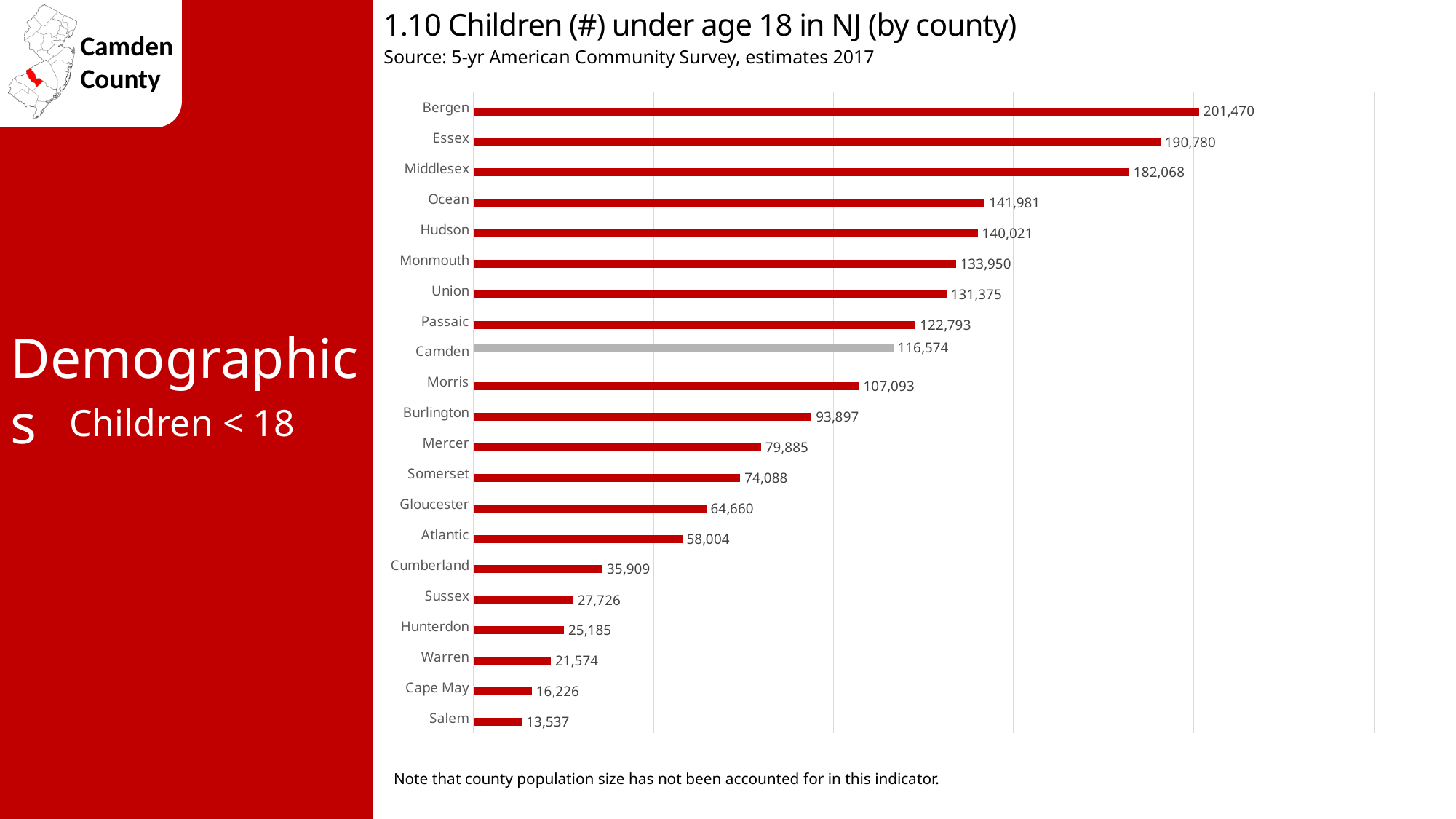
Which county's bar is shown in grey instead of red? Camden Which county has the highest number of children under age 18? Bergen Which county has more children under age 18, Mercer or Somerset? Mercer What is the number of children under age 18 in Ocean County? 141,981 How many counties are shown in the chart? 21 Which county has the lowest number of children under age 18? Salem What is the number of children under age 18 in Camden County? 116,574 What is the difference between the number of children under 18 in Bergen and Essex counties? 10,690 Which county has more children under age 18, Passaic or Morris? Passaic What is the number of children under age 18 in Gloucester County? 64,660 What type of chart is used on this slide? Bar chart What is the difference between the number of children under 18 in Camden and Burlington counties? 22,677